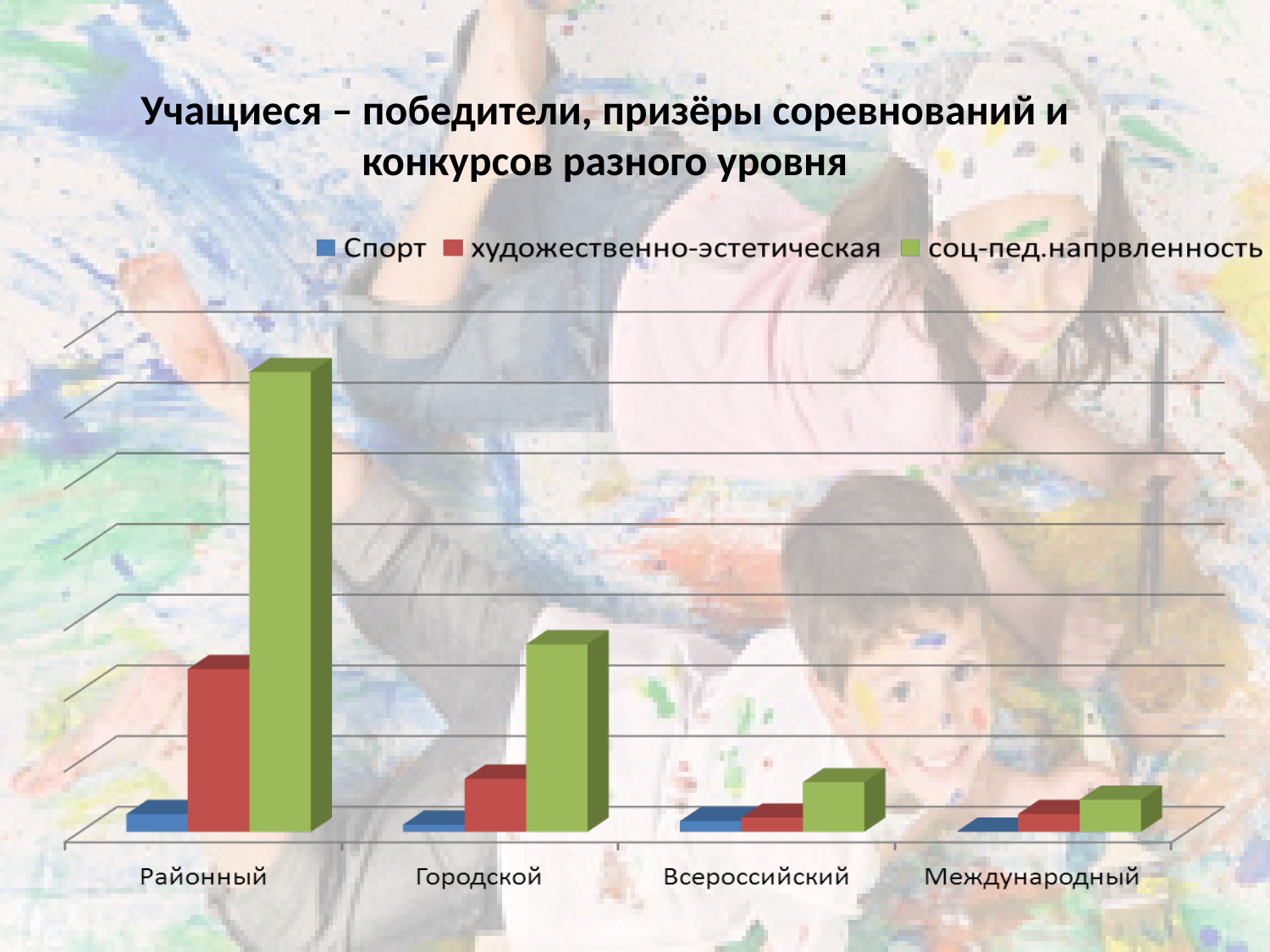
What is the title of the chart on the slide? Учащиеся – победители, призёры соревнований и конкурсов разного уровня What kind of chart is shown on the slide? bar chart Which category has the highest value for the series художественно-эстетическая? Районный Which series has the lowest value in the Районный category? Спорт Which category has the highest value for the series соц-пед.напрвленность? Районный How many series does the chart's legend list? 3 In the Городской category, which is larger: художественно-эстетическая or соц-пед.напрвленность? соц-пед.напрвленность Which category has the lowest value for the series соц-пед.напрвленность? Международный Which series has the highest value in the Районный category? соц-пед.напрвленность For the series соц-пед.напрвленность, which is larger: Районный or Городской? Районный How many categories are shown along the x axis of the chart? 4 Do the values for the series соц-пед.напрвленность rise or fall from Районный to Международный along the x axis? fall